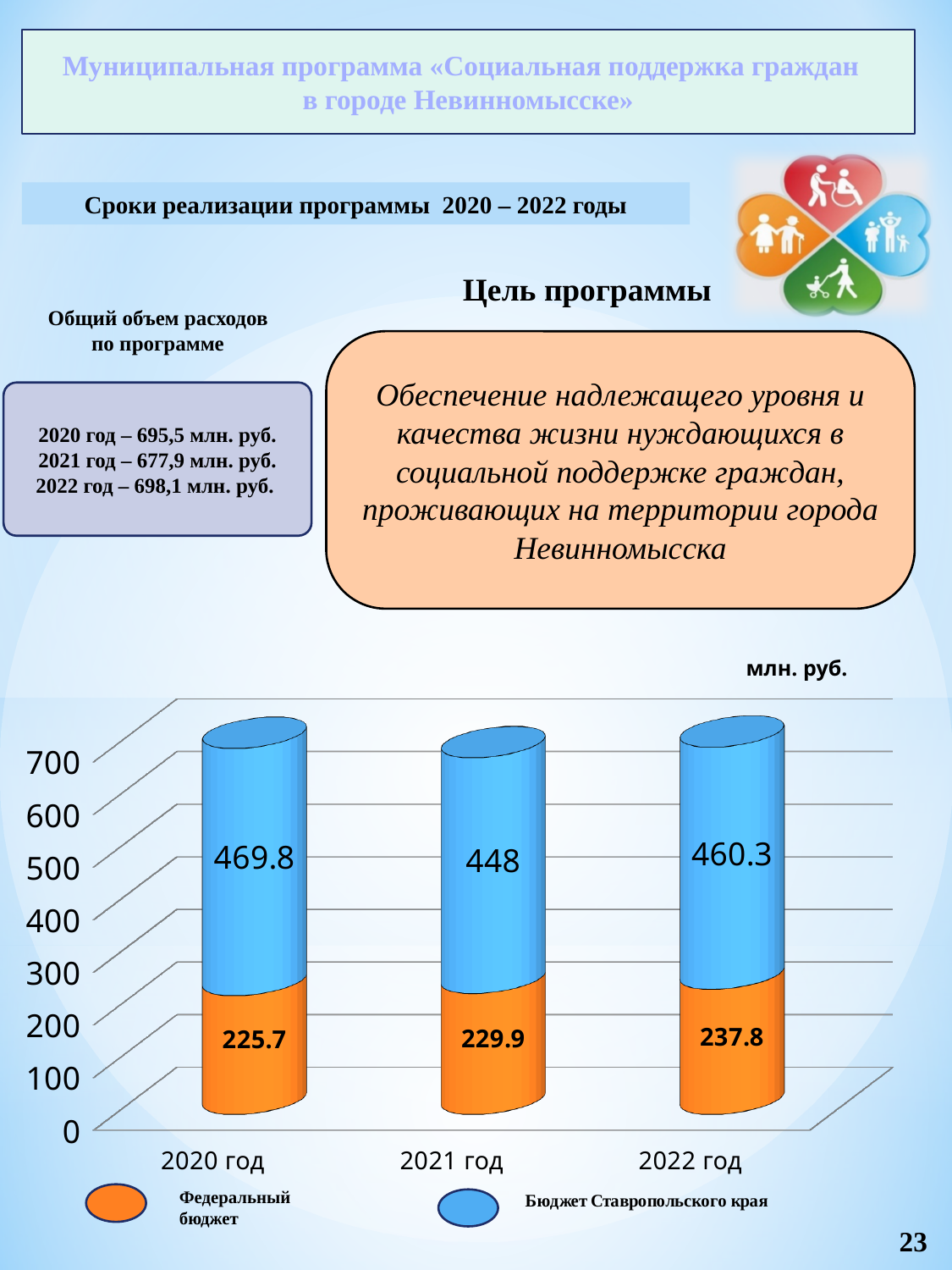
What is the value for Федеральный бюджет in 2022 год? 237.8 Which colour represents Федеральный бюджет in the chart? Orange What is the difference between the Федеральный бюджет values for 2022 год and 2020 год? 12.1 What is the total of the stacked bar for 2021 год? 677.9 In which year is the Бюджет Ставропольского края value the highest? 2020 год How many series does the chart legend list? 2 What is the value for Бюджет Ставропольского края in 2021 год? 448 What is the value for Федеральный бюджет in 2020 год? 225.7 What kind of chart is shown on the slide? Stacked bar chart Which is larger: Бюджет Ставропольского края in 2021 год or in 2022 год? 2022 год How many years are shown on the x axis of the chart? 3 In which year is the Федеральный бюджет value the lowest? 2020 год